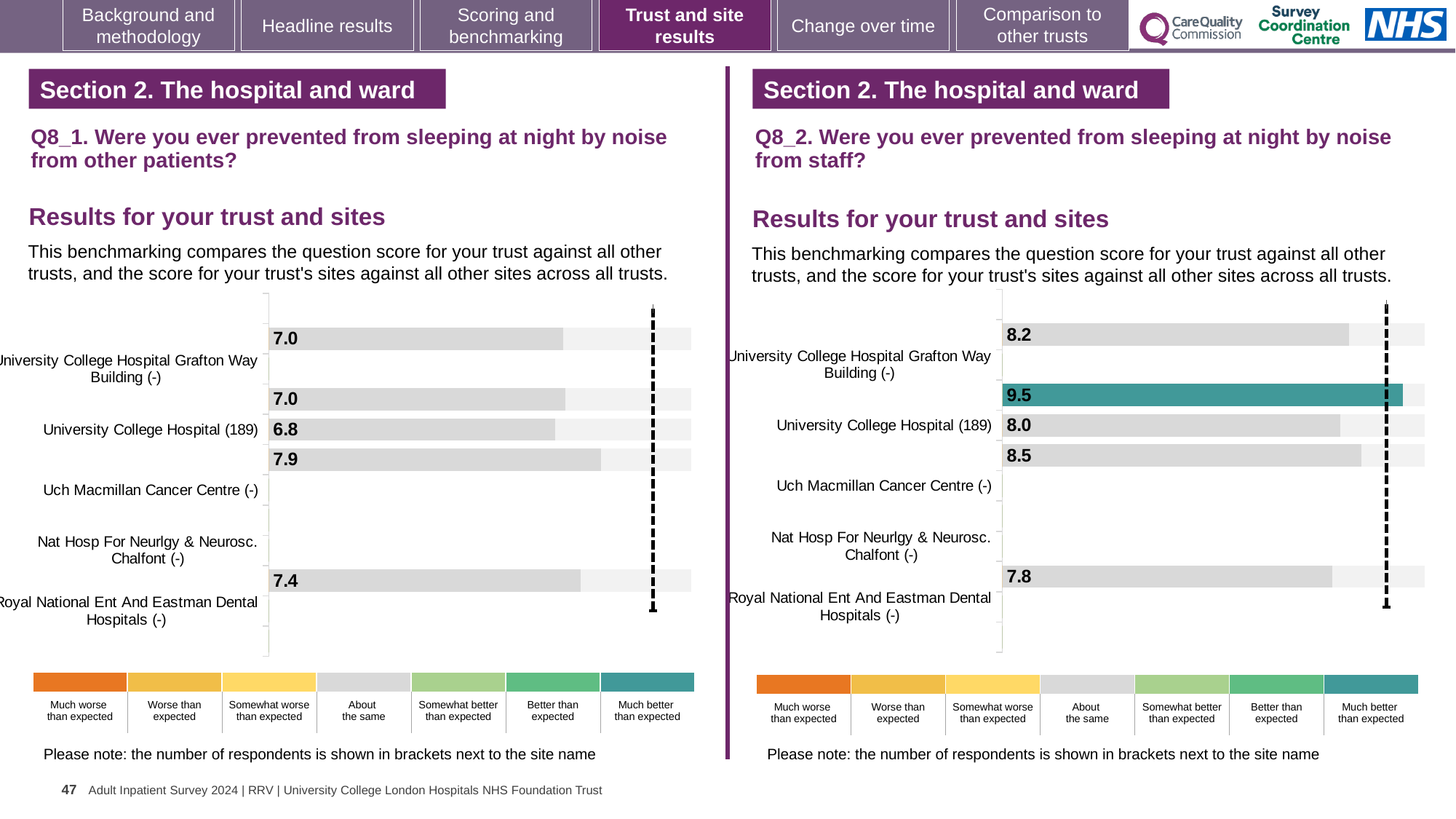
In the left chart (Q8_1, noise from other patients), what is the lowest score shown on any bar? 6.8 In the right chart (Q8_2, noise from staff), what is the lowest score shown on any bar? 7.8 In the right chart (Q8_2), what is the difference between the highest bar value (9.5) and the lowest bar value (7.8)? 1.7 What type of chart is shown on the left side of the slide for Q8_1? bar chart In the right chart (Q8_2), which benchmark category does the teal-coloured bar labelled 9.5 correspond to according to the colour key? Much better than expected How many bars with data labels are plotted in the left chart (Q8_1)? 5 Which chart has the higher maximum bar value, the left chart (Q8_1) or the right chart (Q8_2)? the right chart (Q8_2) How many bars with data labels are plotted in the right chart (Q8_2)? 5 In the left chart (Q8_1), what is the difference between the highest bar value (7.9) and the lowest bar value (6.8)? 1.1 In the left chart (Q8_1, noise from other patients), what is the highest score shown on any bar? 7.9 In the right chart (Q8_2, noise from staff), what is the highest score shown on any bar? 9.5 How many categories does the colour key below each chart list, from 'Much worse than expected' to 'Much better than expected'? 7